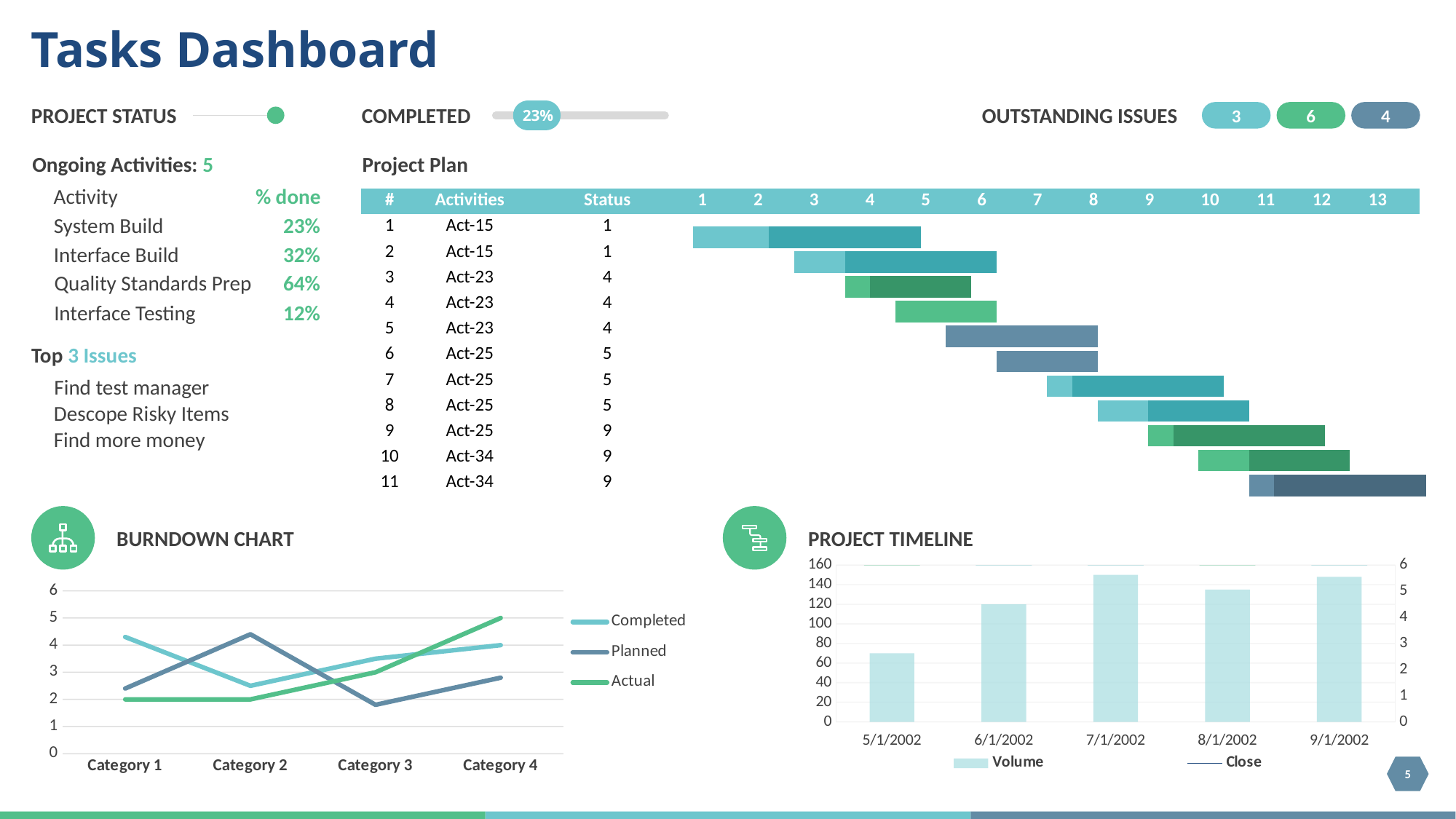
How many series does the legend of the Burndown Chart list? 3 How many categories are shown on the x axis of the Burndown Chart? 4 In the Burndown Chart, does the Actual series rise or fall from Category 2 to Category 4? rise How many bars are shown in the Project Timeline chart? 5 In the Project Timeline chart, which date has the lowest Volume? 5/1/2002 In the Burndown Chart, which is larger at Category 1: Completed or Planned? Completed In the Burndown Chart, which series has the lowest value at Category 3? Planned In the Burndown Chart, is the Planned value at Category 2 greater or less than 4? greater In the Burndown Chart, which series has the highest value at Category 4? Actual What kind of chart is the Project Timeline chart? bar chart In the Project Timeline chart, is the Volume for 7/1/2002 greater or less than 140? greater What kind of chart is the Burndown Chart? line chart